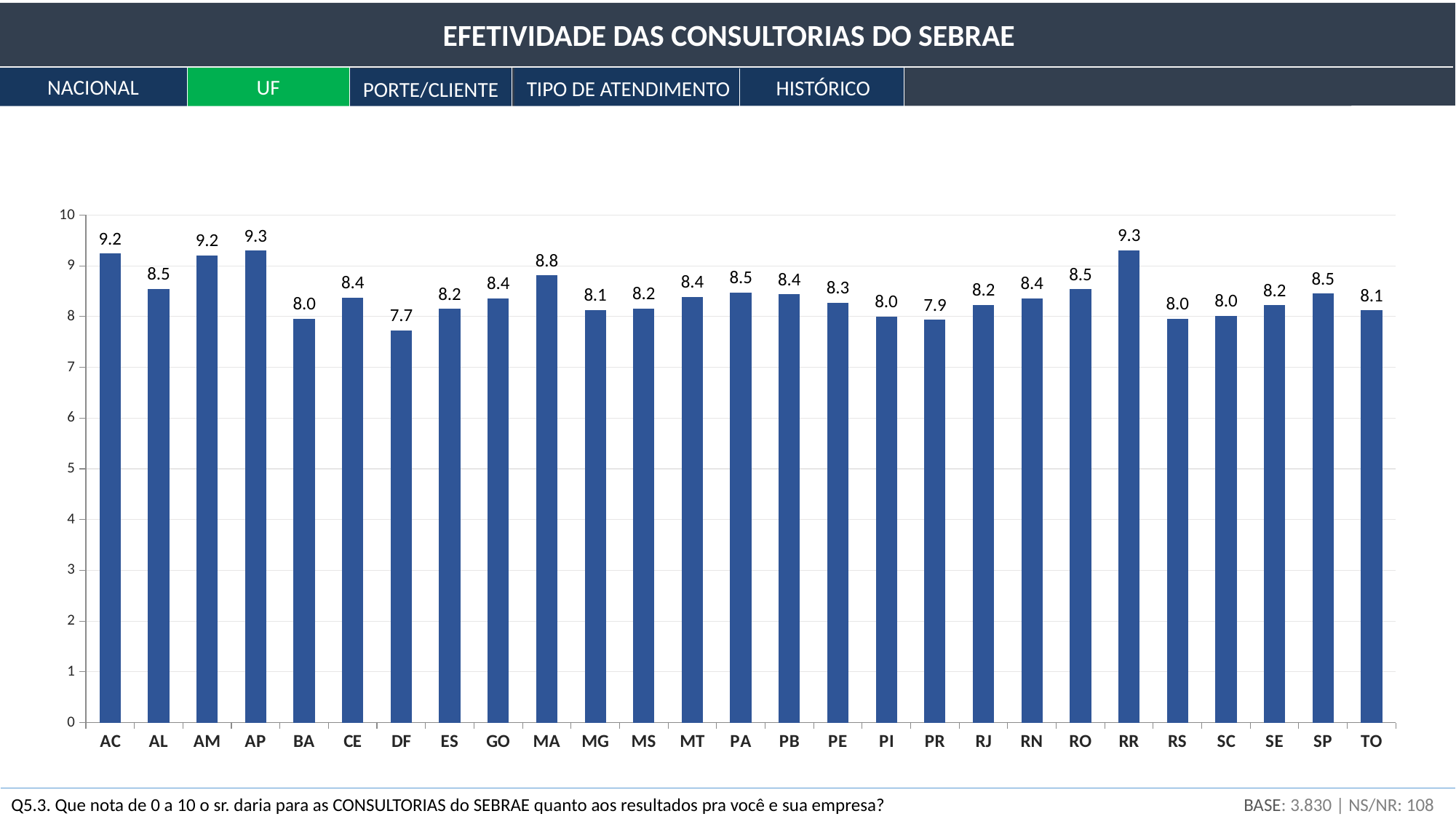
What is the difference between the values for AP and BA? 1.3 What is the difference between the values for MA and DF? 1.1 What is the value for SP? 8.5 What is the value for MA? 8.8 What is the title of the slide? EFETIVIDADE DAS CONSULTORIAS DO SEBRAE Which state has the lowest value? DF Which is larger, the value for AC or the value for AL? AC What is the value for DF? 7.7 What is the value for PR? 7.9 What kind of chart is shown on the slide? bar chart Is the value for RR greater or less than 9? greater How many states are shown on the x axis? 27